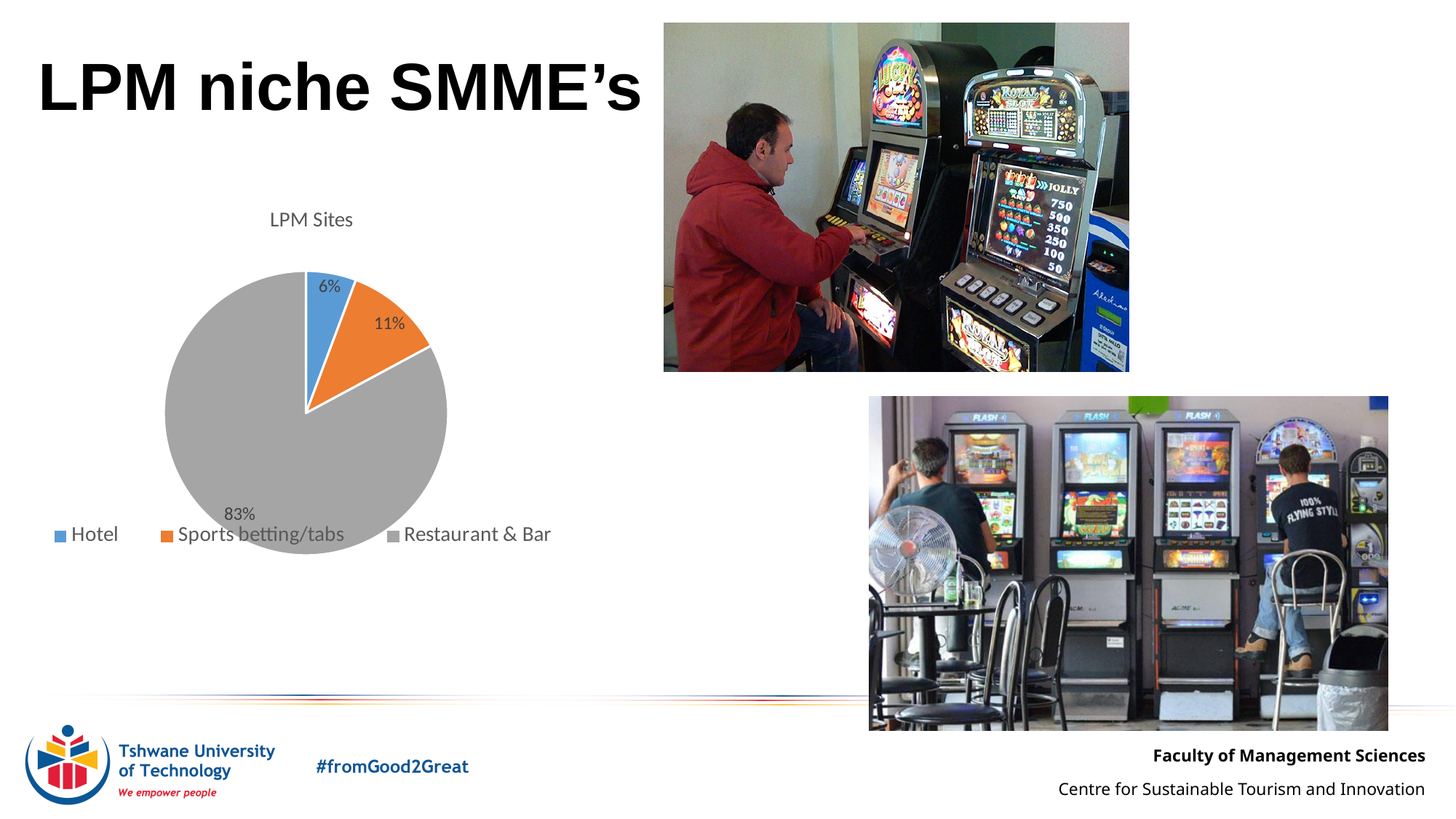
What is the title of the chart? LPM Sites Which category has the largest share of LPM sites? Restaurant & Bar What share of LPM sites is Hotel? 6% What type of chart is shown on the slide? pie chart What share of LPM sites is Restaurant & Bar? 83% What colour represents Restaurant & Bar in the pie chart? grey What is the difference in percentage points between Restaurant & Bar and Sports betting/tabs? 72 Which is larger, the share for Sports betting/tabs or the share for Hotel? Sports betting/tabs How many categories does the pie chart show? 3 What is the difference in percentage points between Sports betting/tabs and Hotel? 5 Which category has the smallest share of LPM sites? Hotel What share of LPM sites is Sports betting/tabs? 11%